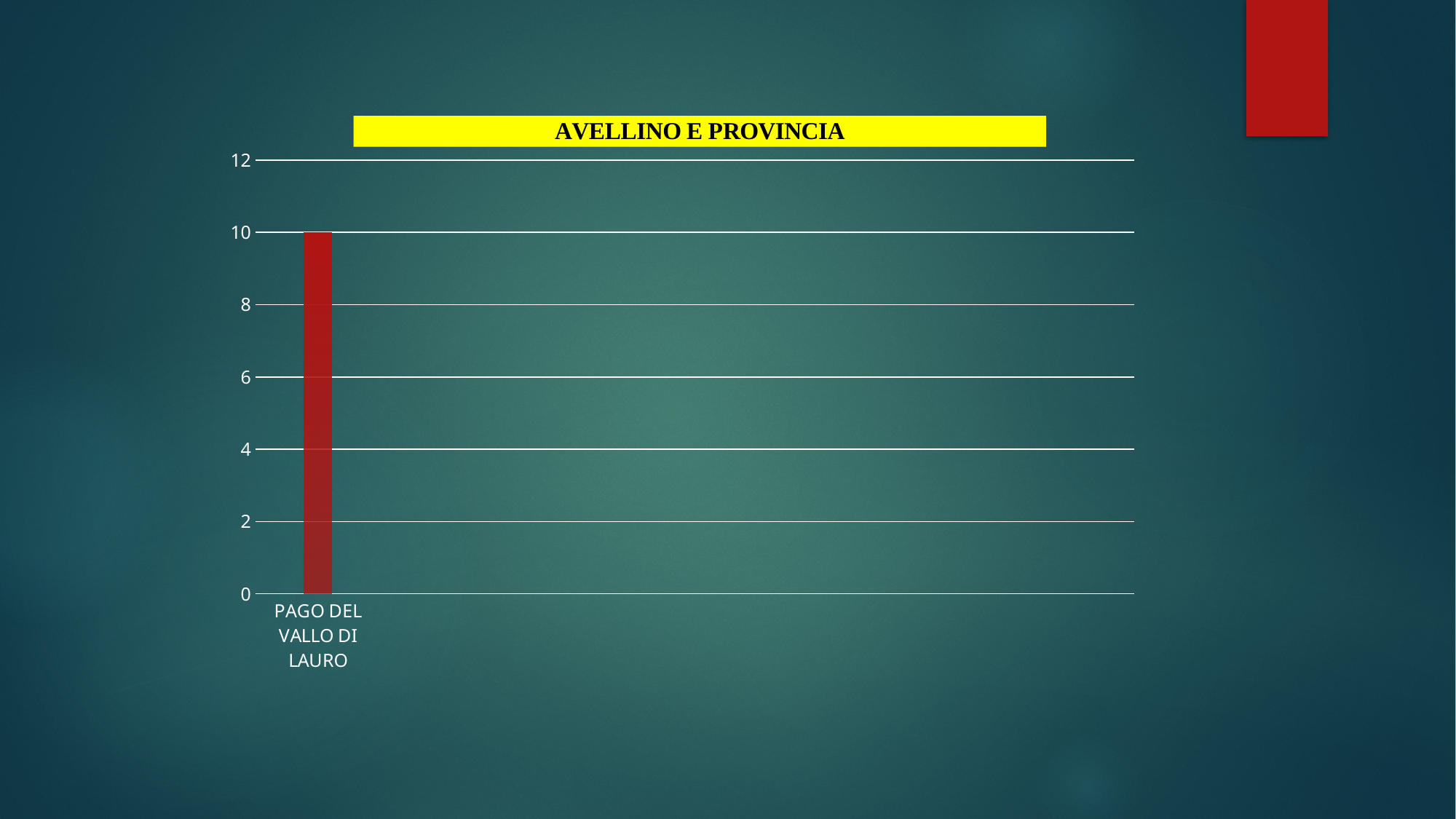
Which category is shown on the x axis of the chart? PAGO DEL VALLO DI LAURO What is the value for PAGO DEL VALLO DI LAURO? 10 Is the value for PAGO DEL VALLO DI LAURO greater or less than 8? greater What kind of chart is shown on the slide? bar chart What colour is the bar in the chart? red What is the highest value shown on the vertical axis? 12 Is the value for PAGO DEL VALLO DI LAURO greater or less than 12? less What is the title of the chart? AVELLINO E PROVINCIA How many categories are plotted on the chart? 1